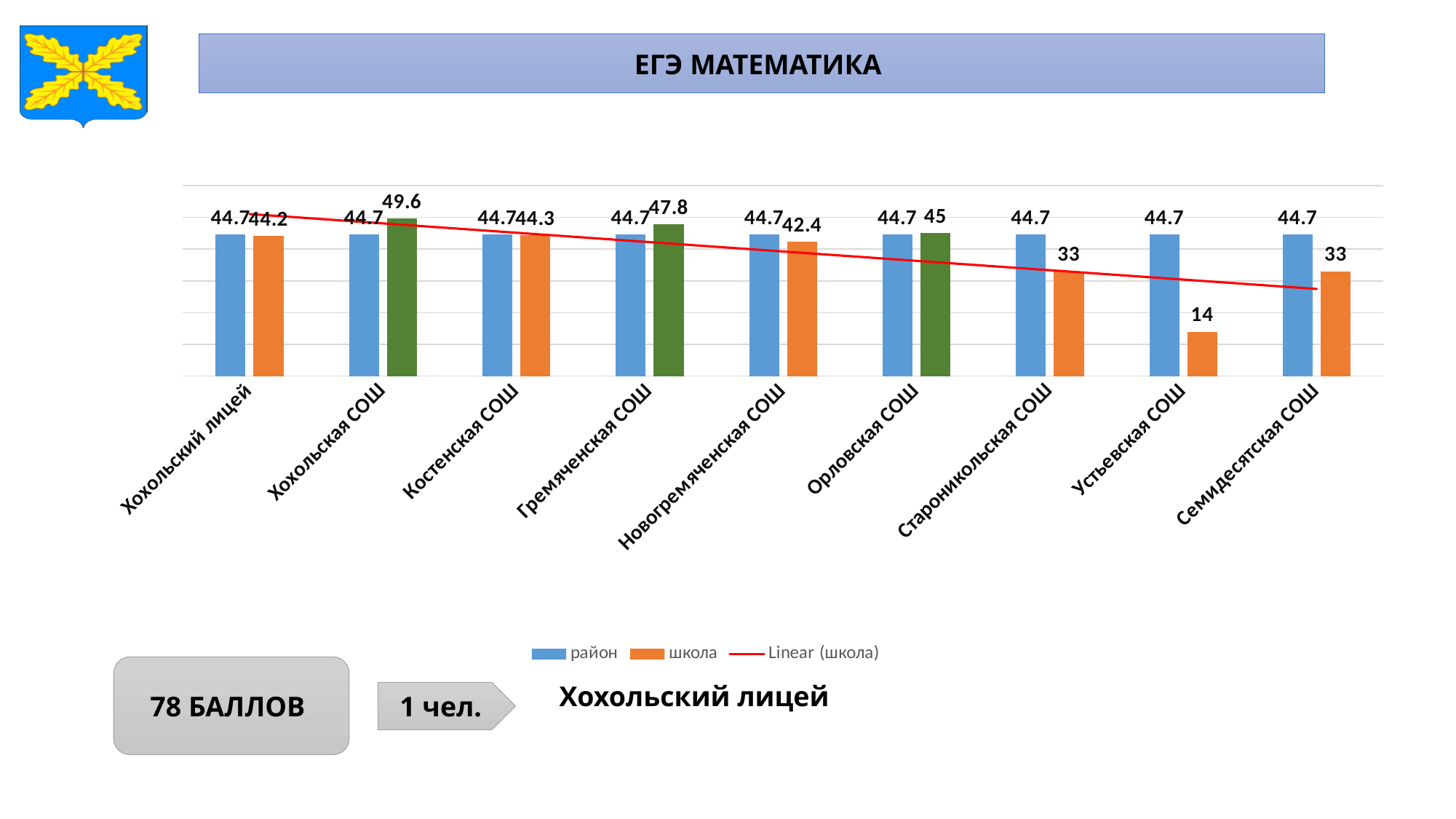
What kind of chart is shown on the slide? bar chart What is the школа value for Новогремяченская СОШ? 42.4 Which school has the highest школа value? Хохольская СОШ How many schools are shown on the x axis? 9 What is the школа value for Хохольская СОШ? 49.6 Which school has the lowest школа value? Устьевская СОШ What is the район value for Орловская СОШ? 44.7 What is the школа value for Устьевская СОШ? 14 What is the difference between the район and школа values for Устьевская СОШ? 30.7 For Гремяченская СОШ, which is larger: the район value or the школа value? школа How many entries does the legend list? 3 By how much does the школа value for Хохольская СОШ exceed its район value? 4.9